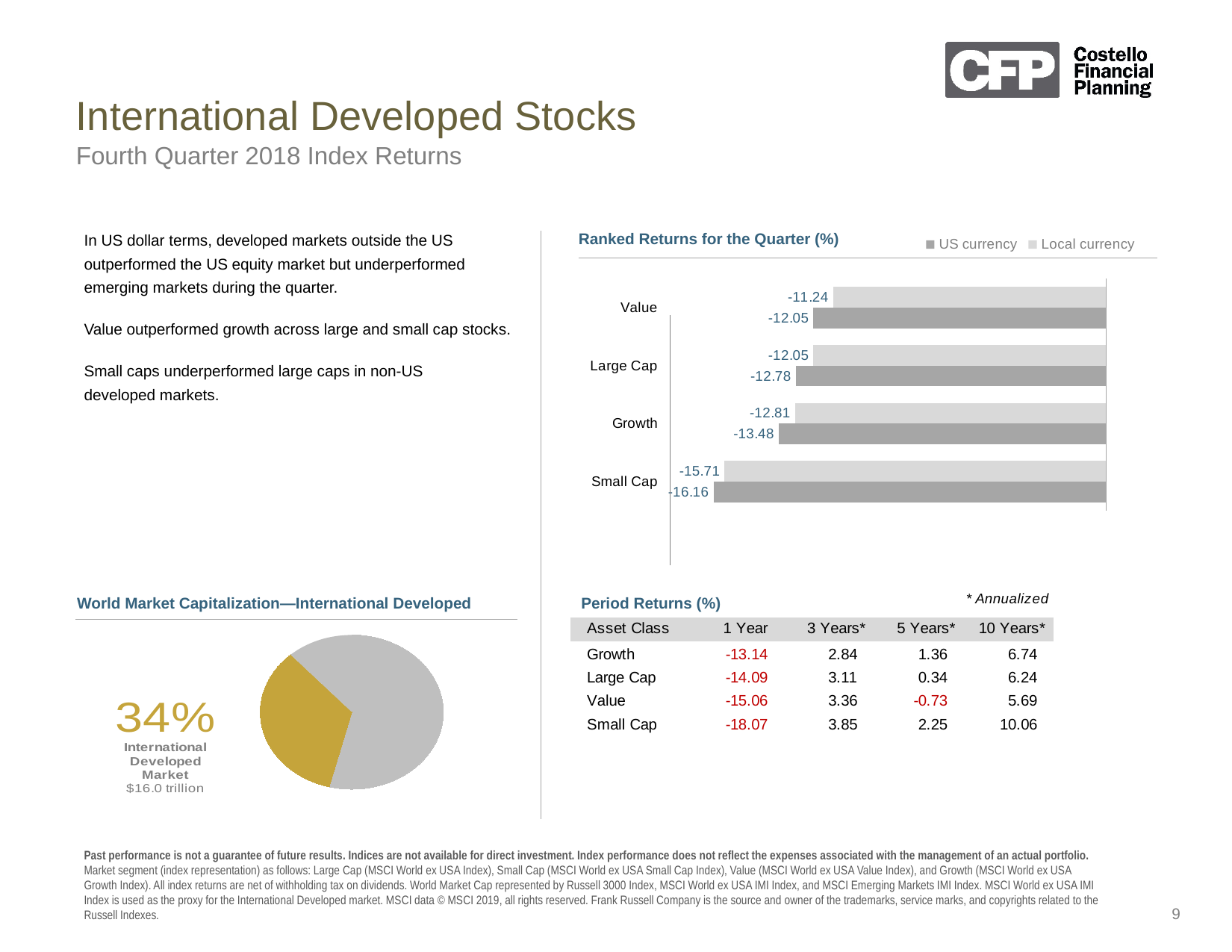
In the Ranked Returns for the Quarter chart, what is the US currency return for Growth? -13.48 In the Ranked Returns for the Quarter chart, which category has the highest Local currency return? Value What kind of chart is the Ranked Returns for the Quarter chart? Bar chart In the Ranked Returns for the Quarter chart, what is the Local currency return for Large Cap? -12.05 How many categories are shown in the Ranked Returns for the Quarter chart? 4 In the Ranked Returns for the Quarter chart, what is the US currency return for Value? -12.05 In the Ranked Returns for the Quarter chart, what is the difference between the Local currency and US currency returns for Small Cap? 0.45 In the World Market Capitalization—International Developed pie chart, what share does the International Developed Market represent? 34% In the Ranked Returns for the Quarter chart, what is the Local currency return for Small Cap? -15.71 In the Ranked Returns for the Quarter chart, which category has the lowest US currency return? Small Cap How many series does the legend of the Ranked Returns for the Quarter chart list? 2 In the Ranked Returns for the Quarter chart, which is larger: the US currency return for Large Cap or the US currency return for Growth? Large Cap